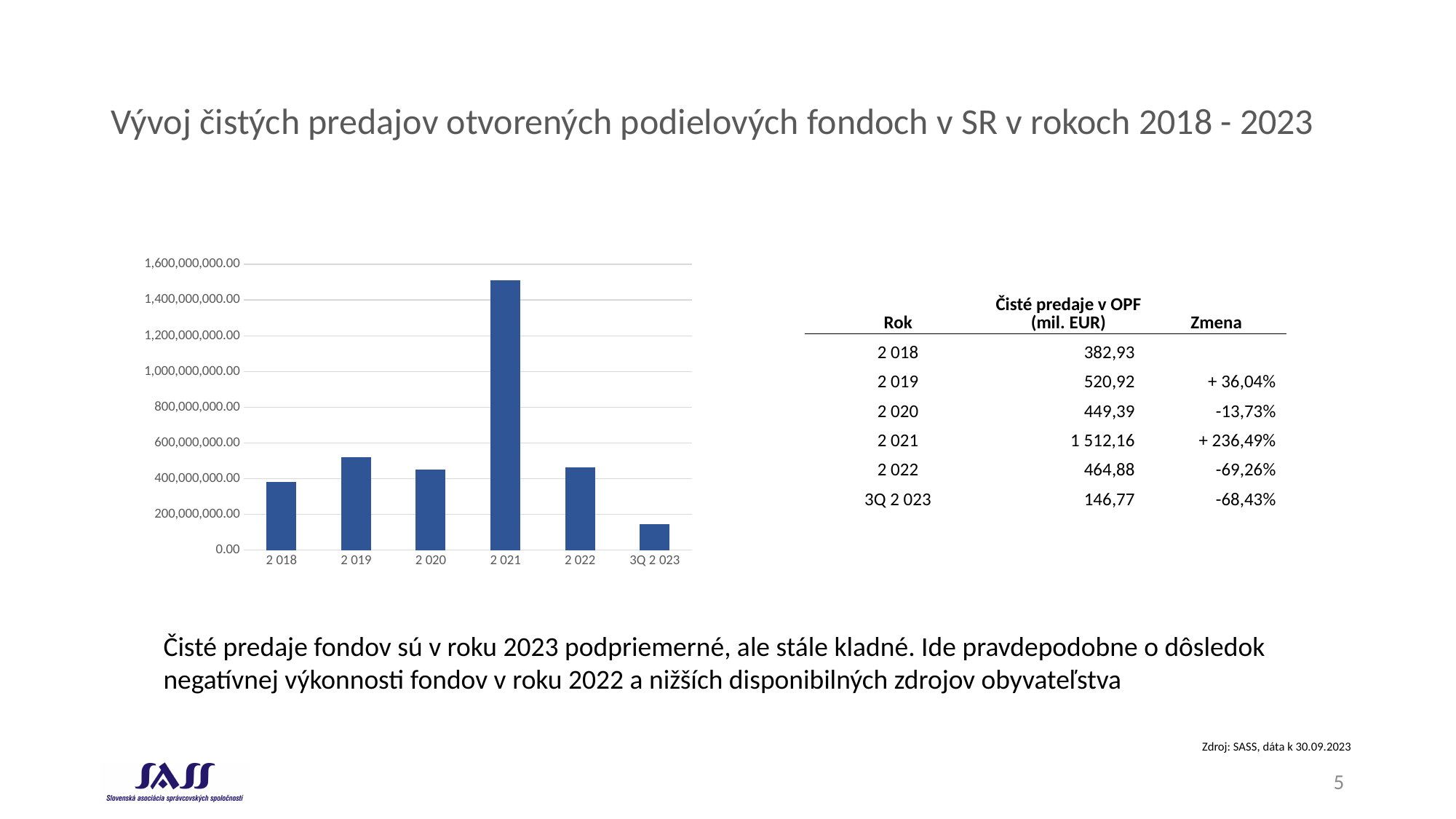
What kind of chart is shown on the slide? bar chart Which bar is taller, 2 019 or 2 020? 2 019 Is the value for 2 019 greater or less than 400,000,000.00? greater How many bars (periods) are shown on the chart? 6 According to the table next to the chart, what are the net sales (Čisté predaje v OPF, mil. EUR) for 2 021? 1 512,16 Which period has the lowest bar on the chart? 3Q 2 023 Is the value for 3Q 2 023 greater or less than 200,000,000.00? less Which bar is taller, 2 018 or 2 022? 2 022 Which period has the highest bar on the chart? 2 021 What is the title of the slide containing the chart? Vývoj čistých predajov otvorených podielových fondoch v SR v rokoch 2018 - 2023 Do the values rise or fall from 2 021 to 3Q 2 023? fall Is the value for 2 021 greater or less than 1,400,000,000.00? greater